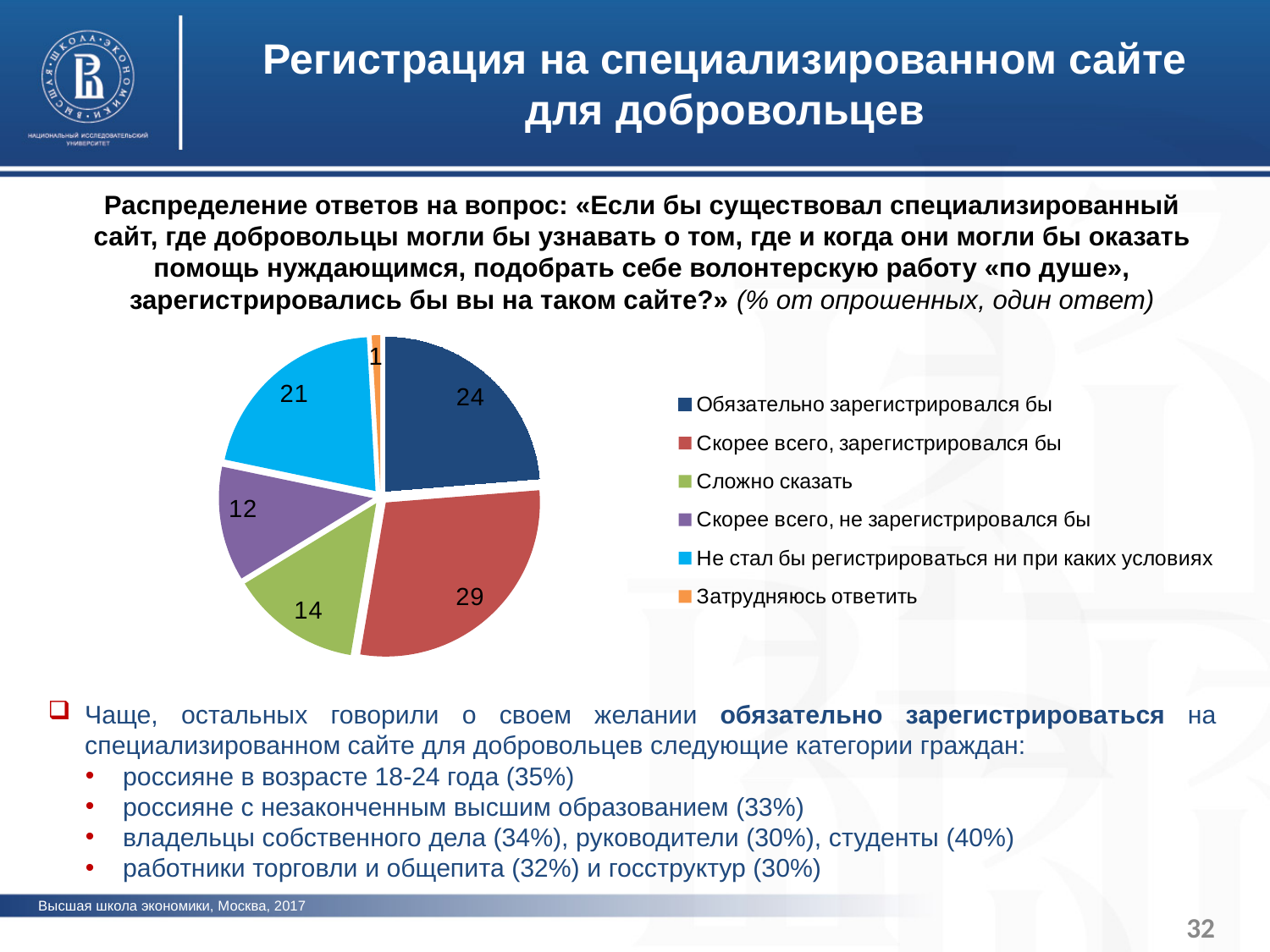
What colour is the slice for «Не стал бы регистрироваться ни при каких условиях»? light blue Which answer option has the largest share of the pie? Скорее всего, зарегистрировался бы What is the value for «Не стал бы регистрироваться ни при каких условиях»? 21 What kind of chart is shown on the slide? pie chart What is the value for «Обязательно зарегистрировался бы»? 24 What is the difference between the values for «Скорее всего, зарегистрировался бы» and «Обязательно зарегистрировался бы»? 5 How many answer options (slices) does the pie chart show? 6 What is the value for «Затрудняюсь ответить»? 1 What is the value for «Сложно сказать»? 14 Which is larger: the value for «Сложно сказать» or the value for «Скорее всего, не зарегистрировался бы»? Сложно сказать Which answer option has the smallest share of the pie? Затрудняюсь ответить What is the value for «Скорее всего, зарегистрировался бы»? 29